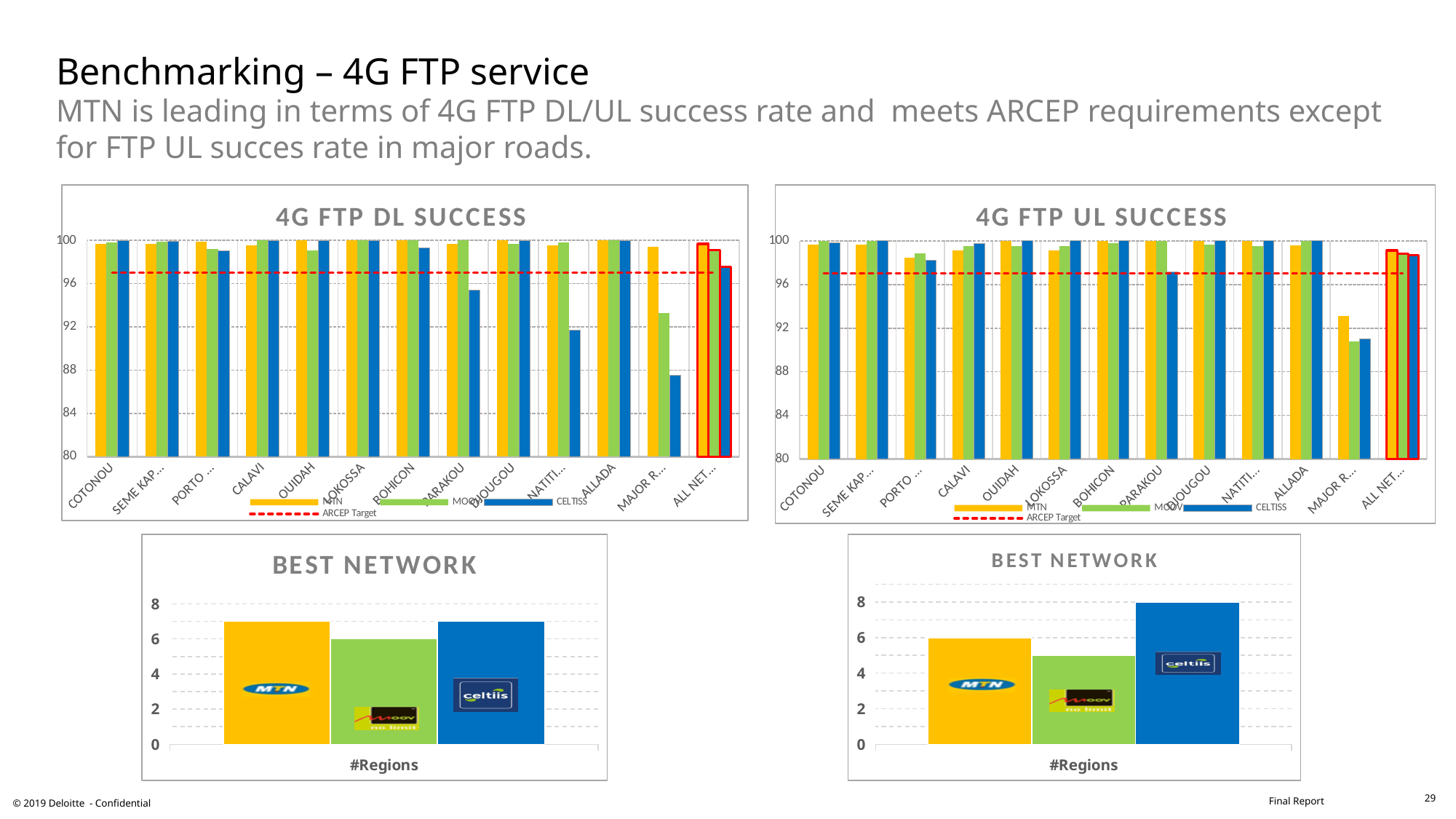
How many entries does the legend of the 4G FTP UL SUCCESS chart list? 4 In the bottom-left BEST NETWORK chart, which network has the lowest value? MOOV In the bottom-right BEST NETWORK chart, which network has the lowest value? MOOV In the bottom-right BEST NETWORK chart, which network has the highest value? CELTIIS In the 4G FTP UL SUCCESS chart, is the value for MTN in MAJOR R... greater or less than 92? greater In the bottom-right BEST NETWORK chart, what is the value for CELTIIS? 8 In the bottom-left BEST NETWORK chart, what is the value for MOOV? 6 In the 4G FTP DL SUCCESS chart, is the value for CELTIIS in PARAKOU greater or less than 96? less In the bottom-right BEST NETWORK chart, what is the value for MTN? 6 In the 4G FTP DL SUCCESS chart, is the value for CELTIIS in MAJOR R... greater or less than 92? less What kind of chart is the bottom-left BEST NETWORK chart? Bar chart In the bottom-right BEST NETWORK chart, what is the difference between the CELTIIS value and the MTN value? 2